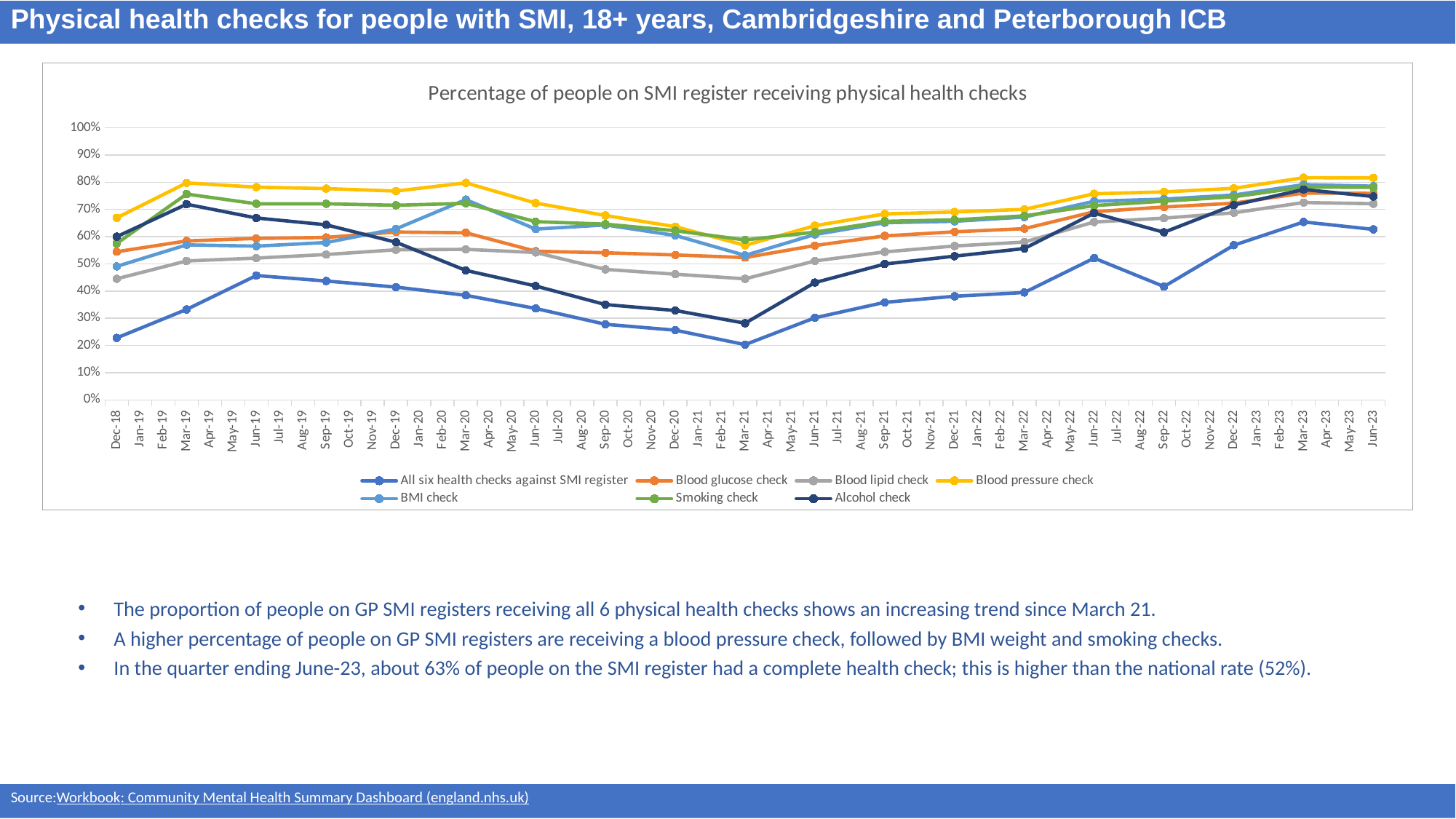
How many series does the legend list? 7 Is the value for 'Alcohol check' at Mar-21 greater or less than 40%? less Which series is plotted in yellow? Blood pressure check From Mar-21 to Jun-23, does the 'All six health checks against SMI register' series generally rise or fall? Rise Which series has the lowest values across the whole period? All six health checks against SMI register Which series has the highest values across most of the period? Blood pressure check What kind of chart is shown on the slide? Line chart At which date does the 'All six health checks against SMI register' series reach its lowest point? Mar-21 What is the title of the chart? Percentage of people on SMI register receiving physical health checks Which is larger for 'All six health checks against SMI register': the value at Dec-18 or the value at Jun-23? Jun-23 Is the value for 'All six health checks against SMI register' at Mar-21 greater or less than 30%? less Is the value for 'Blood pressure check' at Mar-19 greater or less than 70%? greater